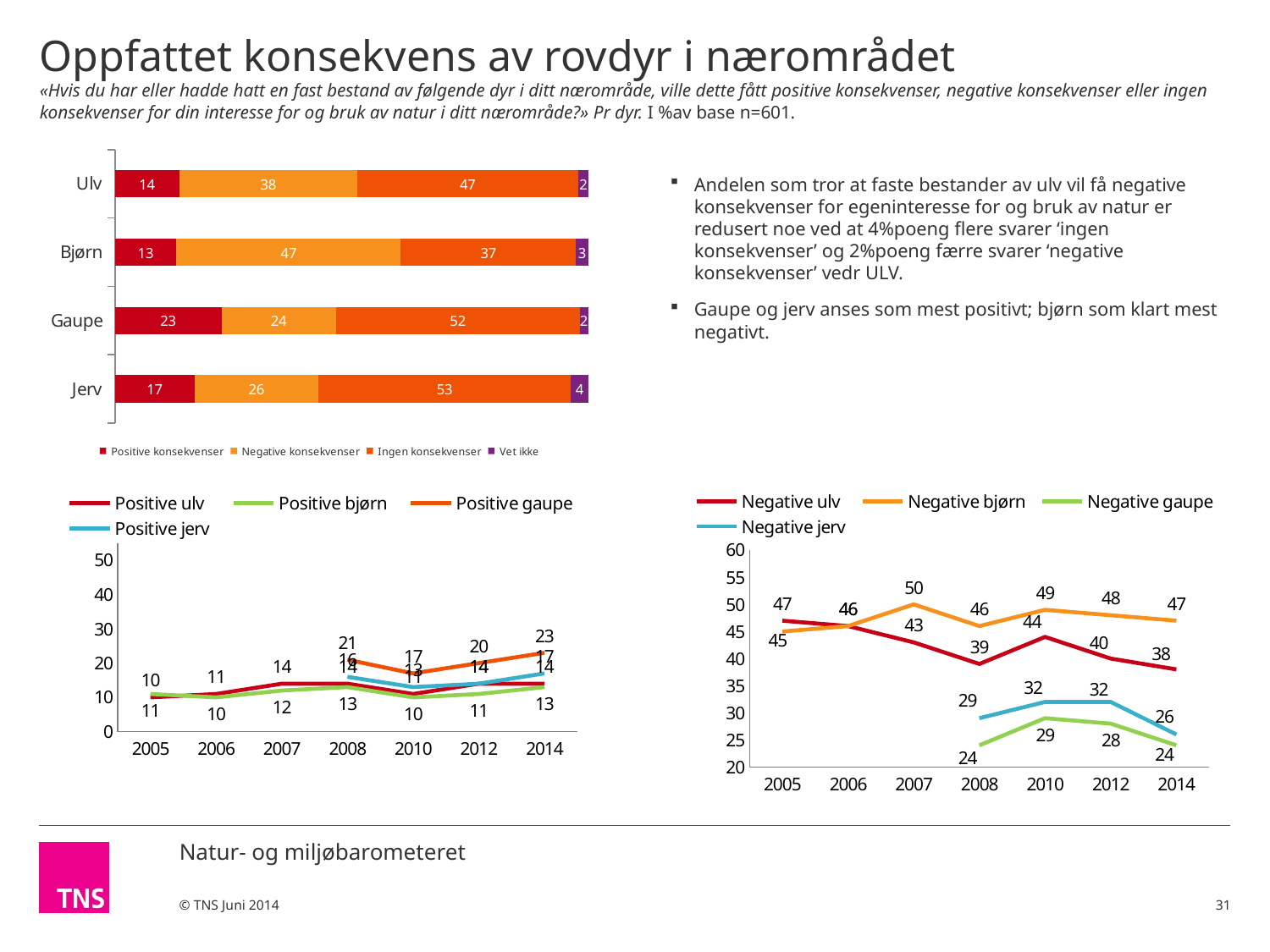
In the 'Negative' line chart at the bottom right, what is the value for Negative ulv in 2014? 38 In the 'Negative' line chart at the bottom right, does the Negative ulv line rise or fall from 2005 to 2014? Fall In the 'Positive' line chart at the bottom left, what is the value for Positive gaupe in 2014? 23 In the stacked bar chart at the top left, how many series does the legend list? 4 In the 'Negative' line chart at the bottom right, what is the value for Negative bjørn in 2007? 50 In the stacked bar chart at the top left, how many categories (animals) are shown? 4 In the 'Negative' line chart at the bottom right, which series has the lowest value in 2014? Negative gaupe In the stacked bar chart at the top left, which animal has the highest 'Positive konsekvenser' value? Gaupe In the stacked bar chart at the top left, what is the difference between the 'Negative konsekvenser' values for Ulv and Gaupe? 14 In the stacked bar chart at the top left, what is the value for 'Ingen konsekvenser' for Jerv? 53 In the stacked bar chart at the top left, what is the value for 'Negative konsekvenser' for Bjørn? 47 What type of chart is the chart at the top left of the slide? Stacked bar chart